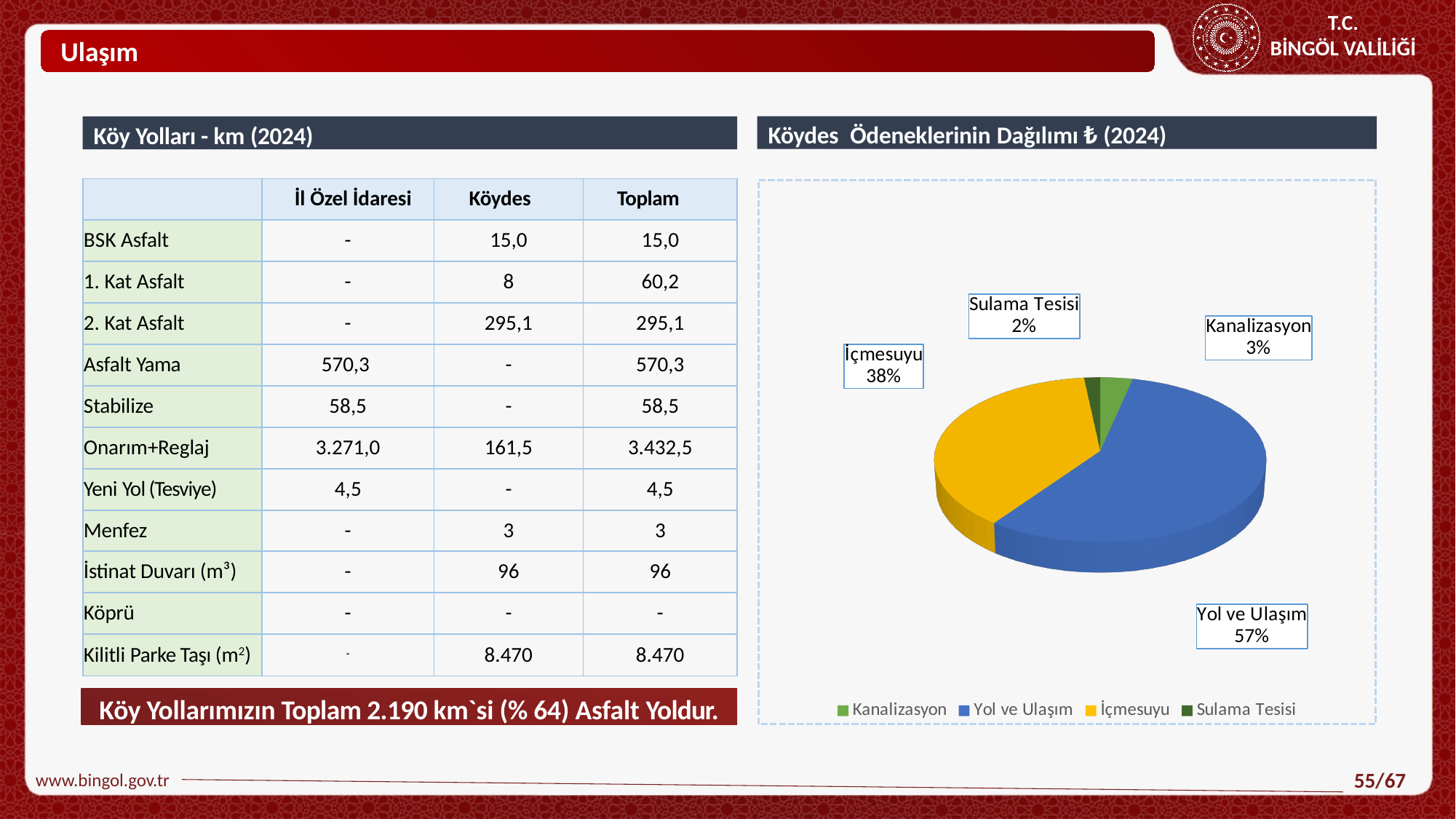
What colour is the Yol ve Ulaşım slice in the pie chart? Blue How many slices does the pie chart have? 4 In the pie chart, what share does Yol ve Ulaşım have? 57% What kind of chart is shown under the title "Köydes Ödeneklerinin Dağılımı ₺ (2024)"? Pie chart Which slice of the pie chart is the largest? Yol ve Ulaşım In the pie chart, what share does Sulama Tesisi have? 2% What is the difference in percentage points between the Yol ve Ulaşım and İçmesuyu slices? 19 Which slice of the pie chart is the smallest? Sulama Tesisi In the pie chart, what share does İçmesuyu have? 38% Which is larger in the pie chart, İçmesuyu or Kanalizasyon? İçmesuyu How many entries does the pie chart's legend list? 4